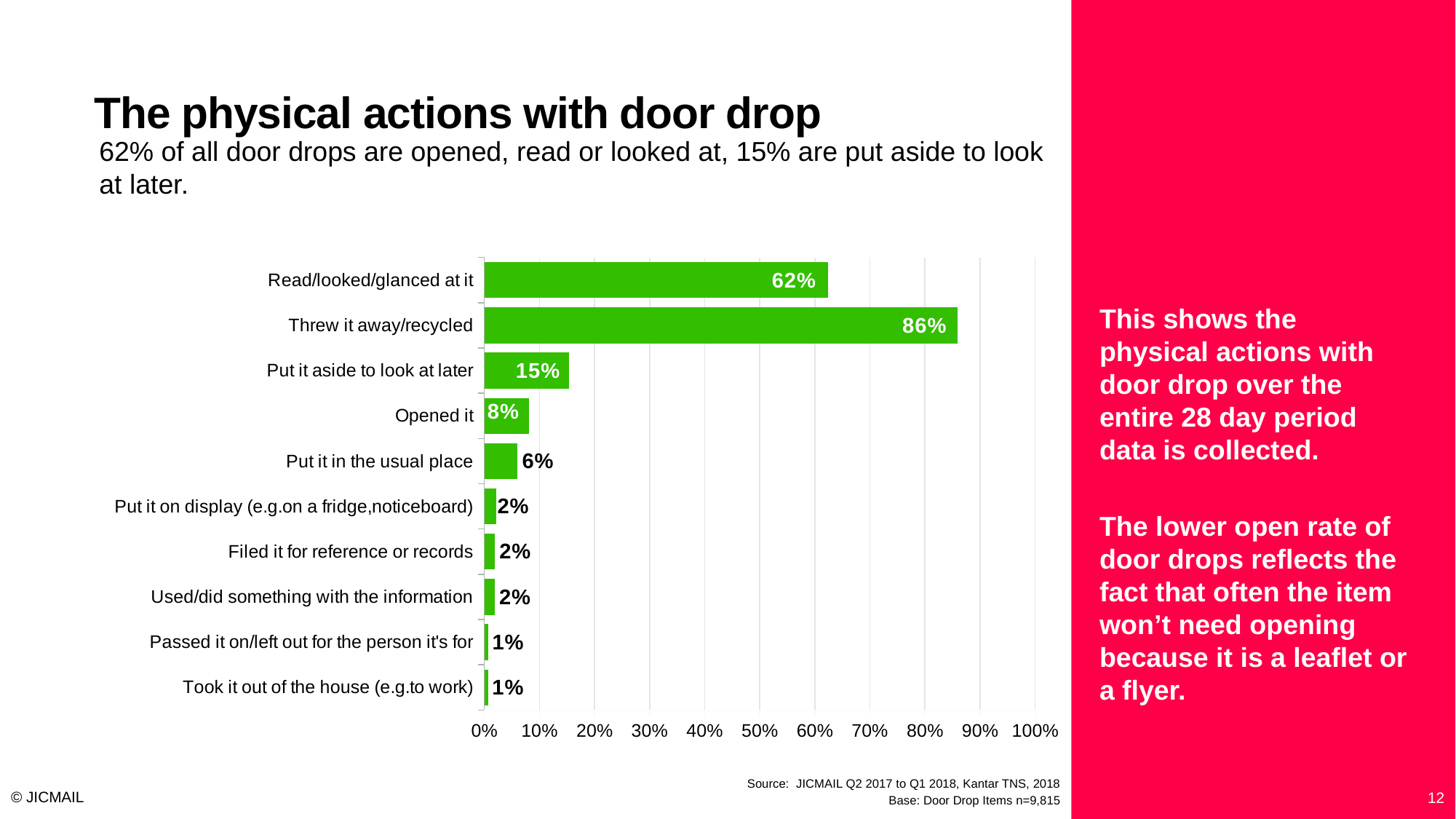
Which physical action has the highest percentage? Threw it away/recycled What is the difference between 'Put it aside to look at later' and 'Opened it'? 7% What is the value for 'Put it in the usual place'? 6% What percentage of door drops were put aside to look at later? 15% How many physical action categories are shown in the chart? 10 What is the difference between 'Threw it away/recycled' and 'Read/looked/glanced at it'? 24% What colour are the bars in the chart? Green What is the value for 'Opened it'? 8% What kind of chart is shown on the slide? Bar chart What is the value for 'Threw it away/recycled'? 86% Which is larger: 'Put it in the usual place' or 'Opened it'? Opened it What percentage of door drops were read/looked/glanced at? 62%